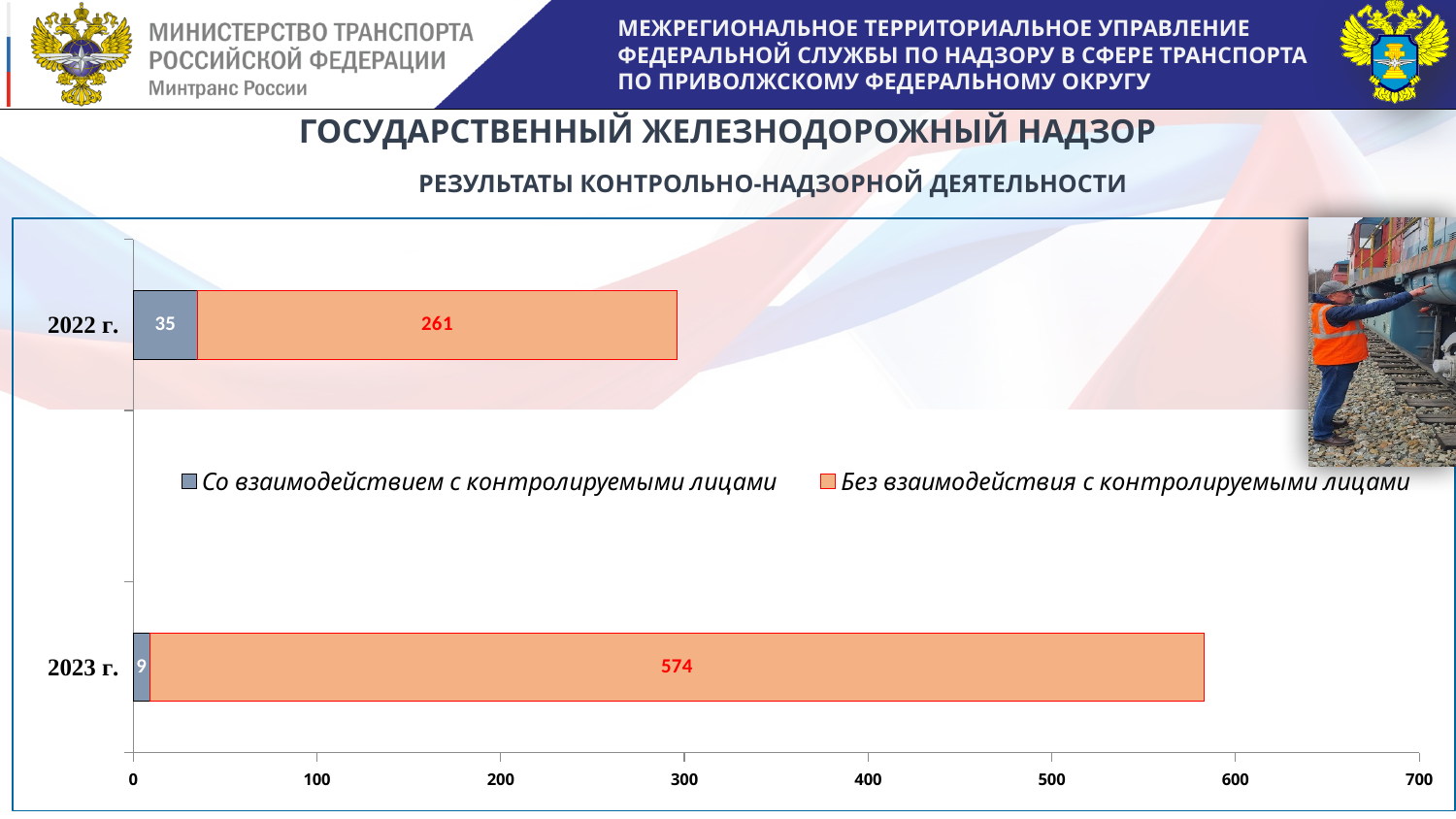
Which year has the lower value for "Со взаимодействием с контролируемыми лицами"? 2023 г. What is the value for "Со взаимодействием с контролируемыми лицами" in 2023 г.? 9 What kind of chart is shown on the slide? Stacked bar chart What is the difference between the "Без взаимодействия с контролируемыми лицами" values for 2023 г. and 2022 г.? 313 How many series does the legend list? 2 What is the value for "Без взаимодействия с контролируемыми лицами" in 2023 г.? 574 What is the total of the stacked bar for 2022 г.? 296 What is the value for "Со взаимодействием с контролируемыми лицами" in 2022 г.? 35 Which year has the higher value for "Без взаимодействия с контролируемыми лицами"? 2023 г. What is the total of the stacked bar for 2023 г.? 583 What is the value for "Без взаимодействия с контролируемыми лицами" in 2022 г.? 261 How many categories (years) are shown on the chart? 2